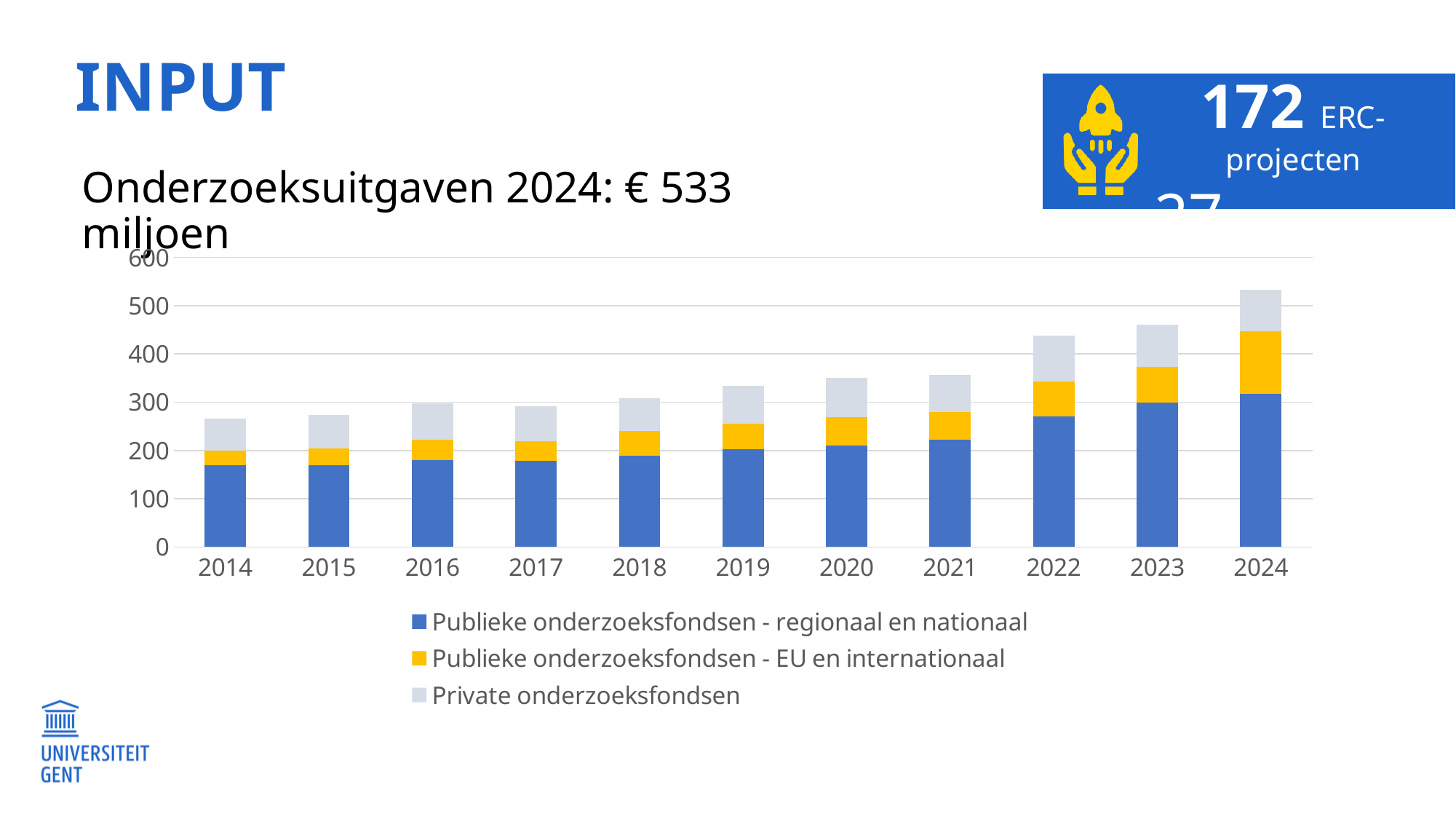
How many years are shown on the x axis of the chart? 11 Do the total bar heights generally rise or fall from 2014 to 2024? rise What kind of chart is shown on the slide? stacked bar chart Which year has the larger total bar, 2021 or 2022? 2022 Which year has the highest total bar in the chart? 2024 According to the slide text, what were the research expenditures (Onderzoeksuitgaven) in 2024? € 533 miljoen Is the total bar for 2021 greater or less than 400? less Is the total bar for 2022 greater or less than 400? greater Is the total bar for 2024 greater or less than 500? greater How many series does the chart legend list? 3 Which colour represents 'Private onderzoeksfondsen' in the chart legend? light grey